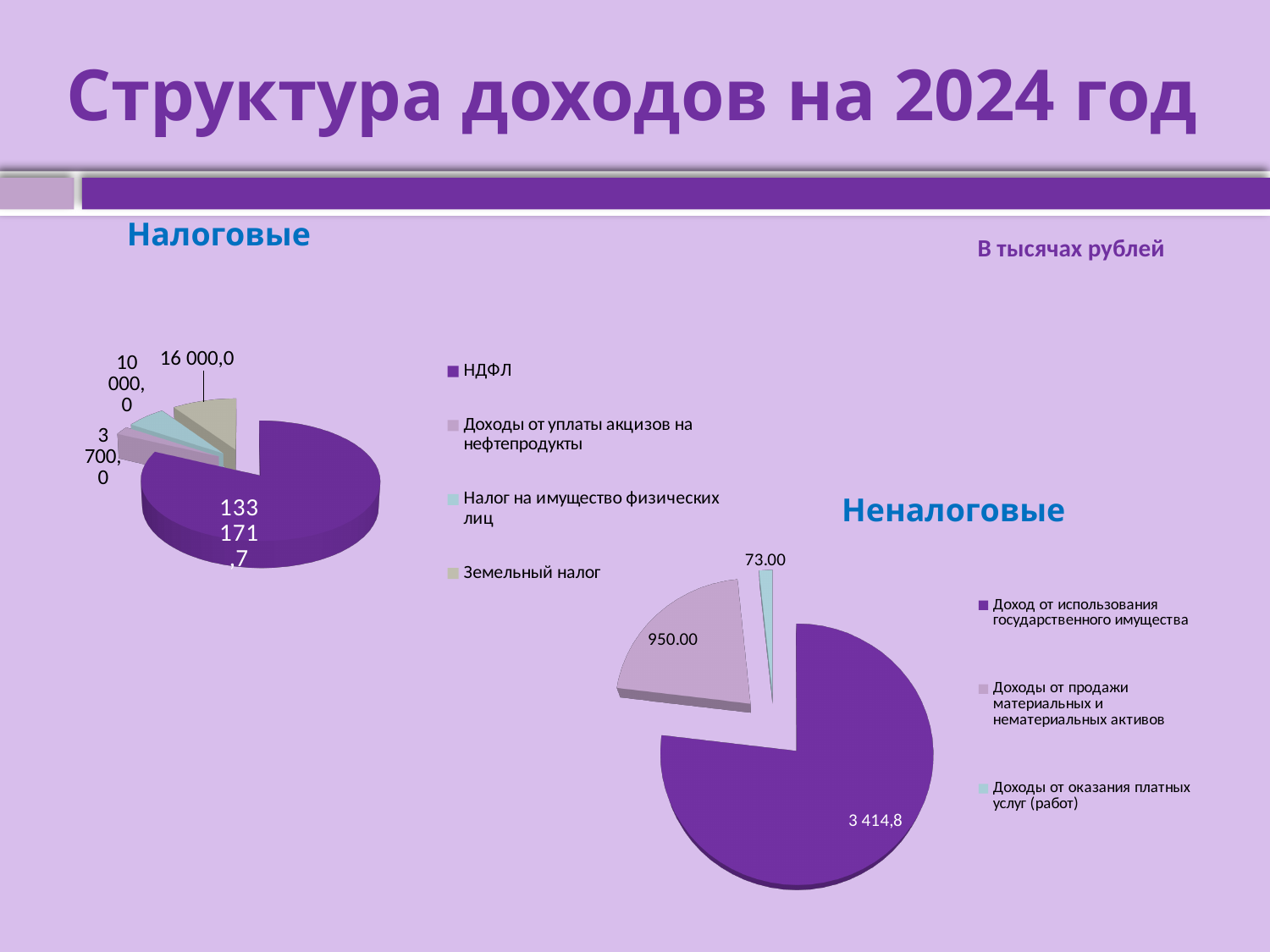
In the "Налоговые" chart, what is the value for НДФЛ? 133 171,7 In the "Неналоговые" chart, which is larger: Доходы от продажи материальных и нематериальных активов or Доходы от оказания платных услуг (работ)? Доходы от продажи материальных и нематериальных активов In the "Налоговые" chart, which category has the largest value? НДФЛ In the "Налоговые" chart, how many categories does the legend list? 4 In the "Неналоговые" chart, what is the difference between Доходы от продажи материальных и нематериальных активов and Доходы от оказания платных услуг (работ)? 877.00 In the "Неналоговые" chart, what is the value for Доход от использования государственного имущества? 3 414,8 In the "Неналоговые" chart, what is the value for Доходы от оказания платных услуг (работ)? 73.00 In what units are the values on the slide given? В тысячах рублей In the "Налоговые" chart, what is the value for Налог на имущество физических лиц? 10 000,0 In the "Налоговые" chart, which category has the smallest value? Доходы от уплаты акцизов на нефтепродукты What kind of chart is the "Налоговые" chart? pie chart In the "Налоговые" chart, what is the value for Земельный налог? 16 000,0